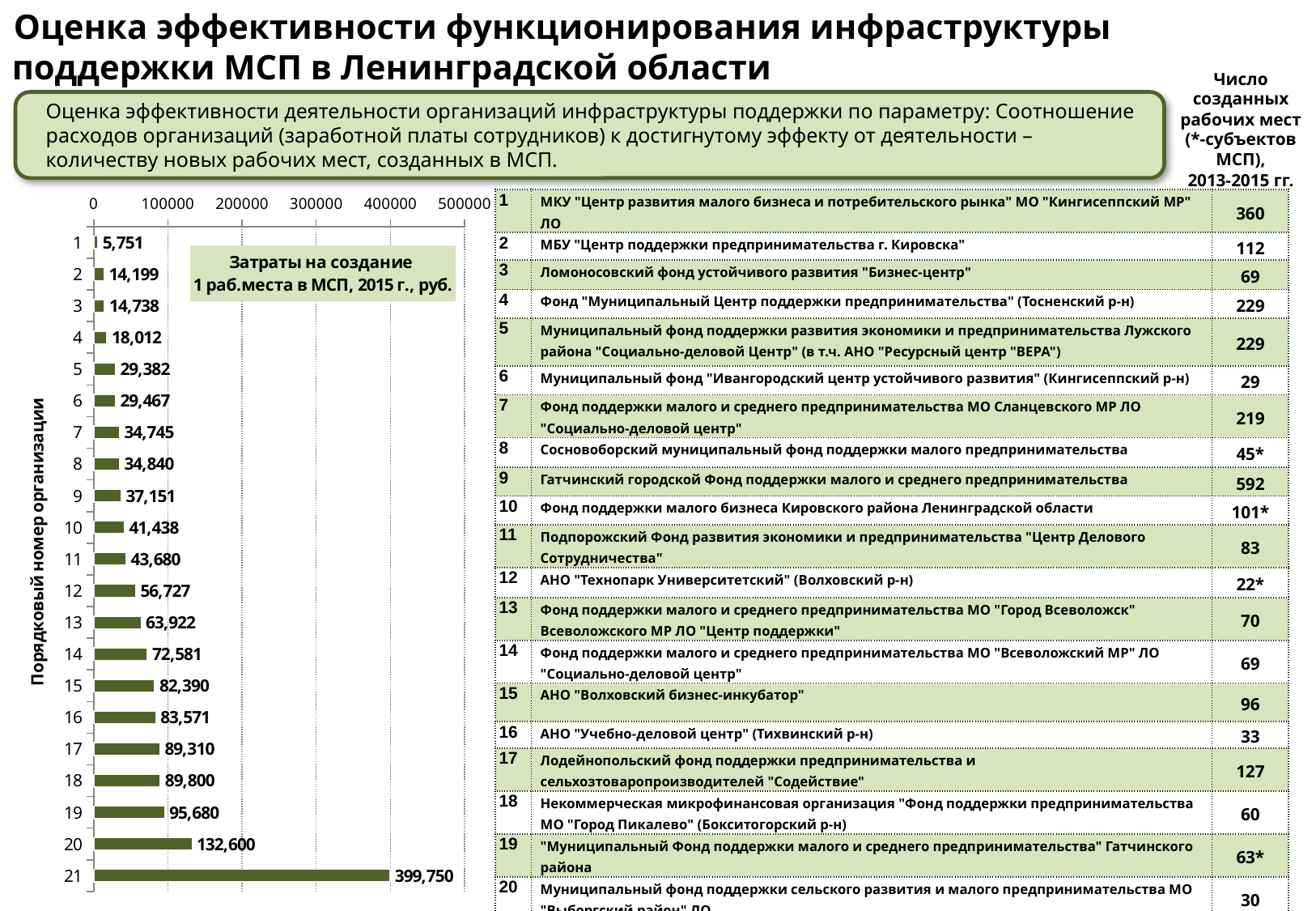
How many organizations (categories) are plotted in the bar chart? 21 What is the label of the vertical axis of the bar chart? Порядковый номер организации What type of chart is shown on the left of the slide? bar chart What is the value for organization number 12 in the bar chart? 56,727 What is the difference between the values for organization 20 and organization 19 in the bar chart? 36,920 What is the title of the bar chart? Затраты на создание 1 раб.места в МСП, 2015 г., руб. Which organization number has the lowest value in the bar chart? 1 What is the value for organization number 1 in the bar chart? 5,751 Which has a larger value in the bar chart, organization 15 or organization 16? 16 Is the value for organization 21 in the bar chart greater or less than 300000? greater Which organization number has the highest value in the bar chart? 21 What is the value for organization number 21 in the bar chart? 399,750